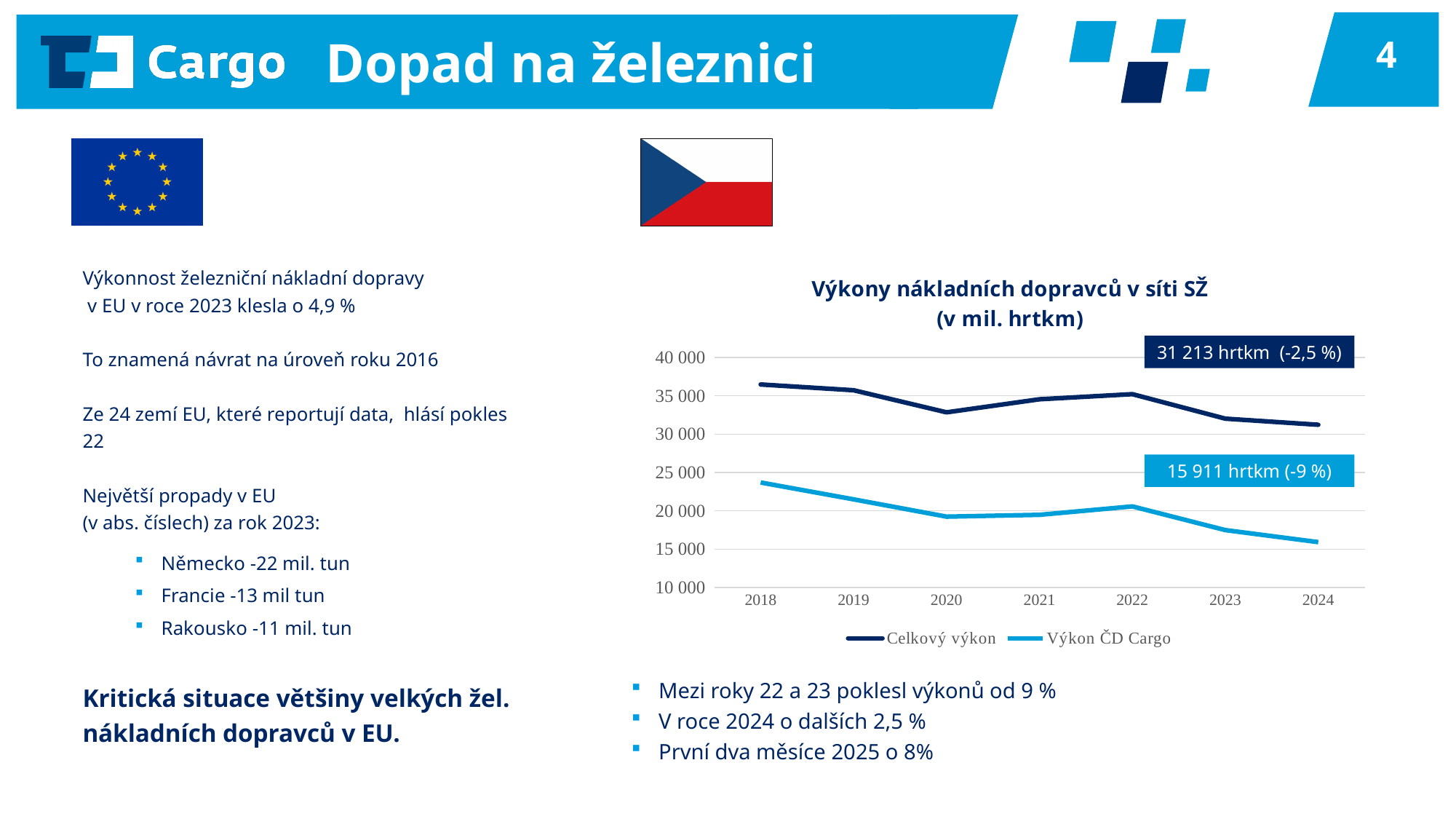
What percentage change is shown next to the 2024 value for Výkon ČD Cargo? -9 % Overall, do the values for Výkon ČD Cargo rise or fall from 2018 to 2024? fall In which year is Celkový výkon highest? 2018 What value is labelled for Celkový výkon in 2024? 31 213 hrtkm Is the value for Výkon ČD Cargo in 2023 greater or less than 20 000? less How many years are shown on the x axis of the chart? 7 What value is labelled for Výkon ČD Cargo in 2024? 15 911 hrtkm What is the title of the chart? Výkony nákladních dopravců v síti SŽ (v mil. hrtkm) Is the value for Celkový výkon in 2018 greater or less than 35 000? greater How many series does the chart legend list? 2 In which year is Výkon ČD Cargo lowest? 2024 What type of chart is shown on the slide? line chart